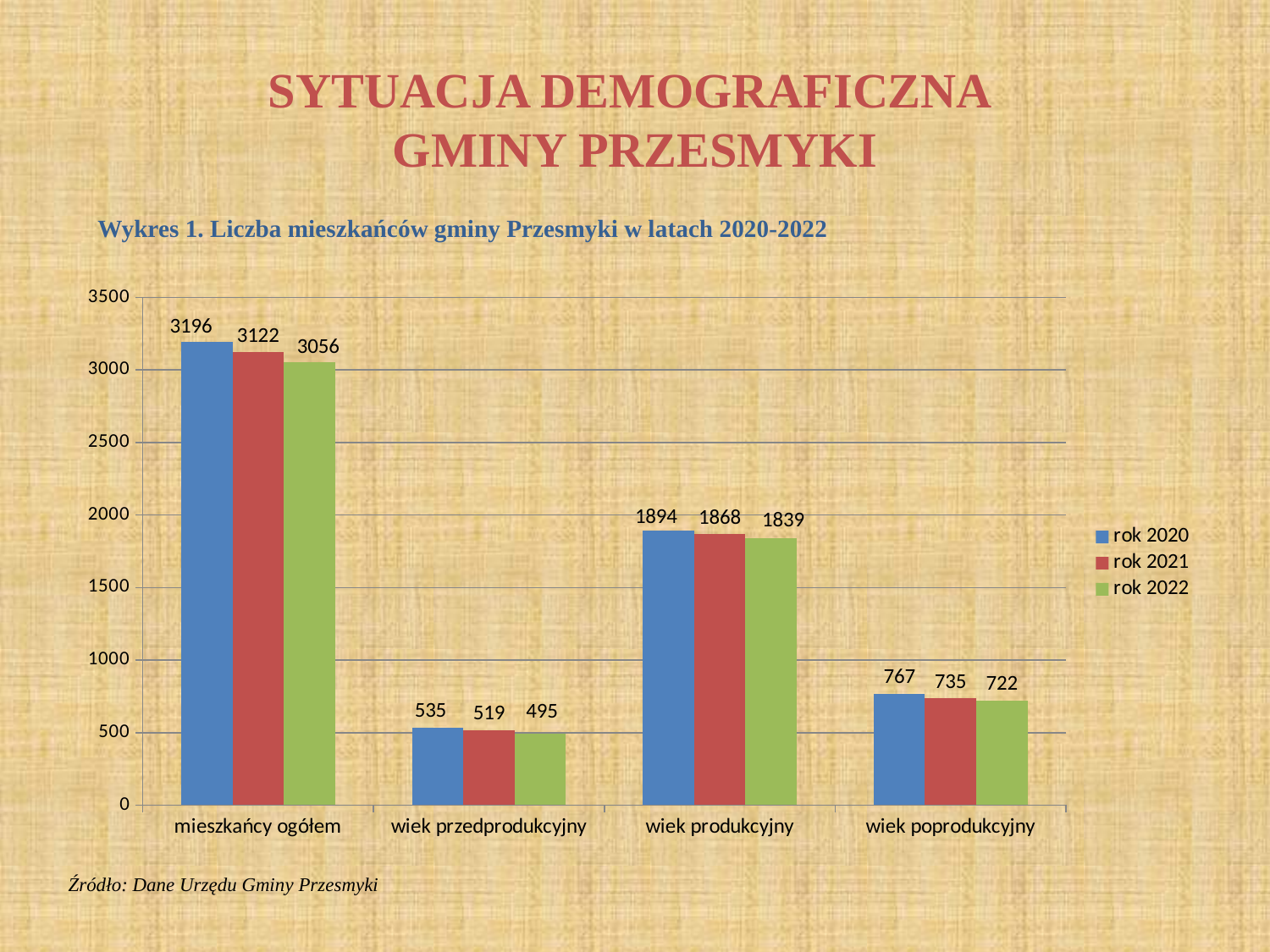
Which is larger: the 'rok 2020' value for 'wiek produkcyjny' or the 'rok 2022' value for 'wiek produkcyjny'? rok 2020 What is the value for 'mieszkańcy ogółem' in the 'rok 2020' series? 3196 What is the value for 'wiek przedprodukcyjny' in the 'rok 2022' series? 495 Which category has the highest value in the 'rok 2022' series? mieszkańcy ogółem How many categories are shown on the x axis? 4 What is the difference between the 'rok 2020' and 'rok 2021' values for 'wiek poprodukcyjny'? 32 What is the value for 'wiek produkcyjny' in the 'rok 2021' series? 1868 Which category has the lowest value in the 'rok 2021' series? wiek przedprodukcyjny How many series does the legend list? 3 What kind of chart is shown on the slide? bar chart What is the value for 'wiek poprodukcyjny' in the 'rok 2020' series? 767 What is the difference between the 'rok 2020' and 'rok 2022' values for 'mieszkańcy ogółem'? 140